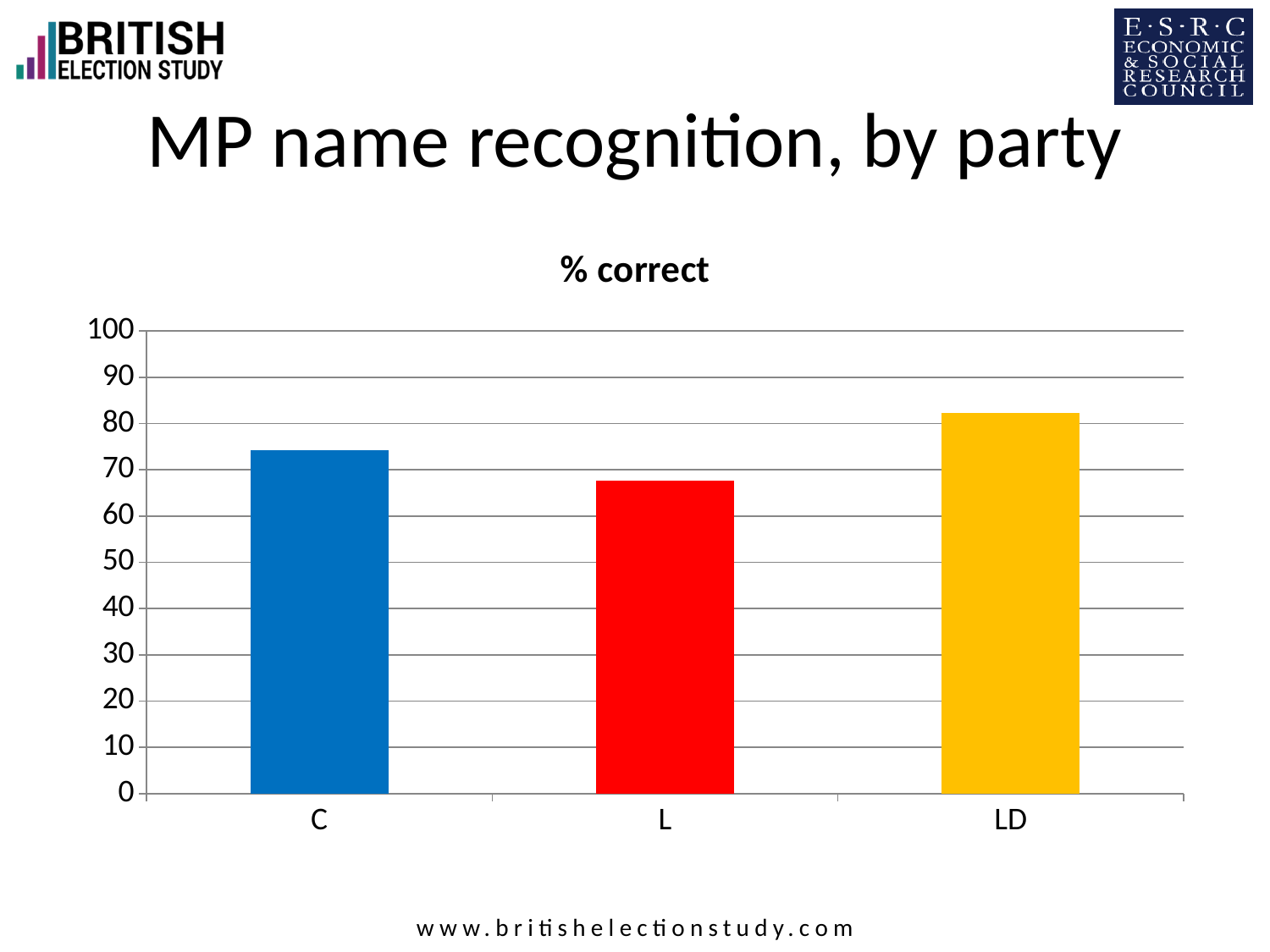
Is the value for L greater or less than 70? less Is the value for L greater or less than 60? greater What is the title of the chart? % correct Which party has the highest % correct? LD Which has a higher % correct, C or L? C Is the value for LD greater or less than 80? greater How many parties are shown on the x axis of the chart? 3 Which party has the lowest % correct? L What kind of chart is shown on the slide? bar chart Which has a higher % correct, LD or C? LD What colour is the bar for LD? yellow